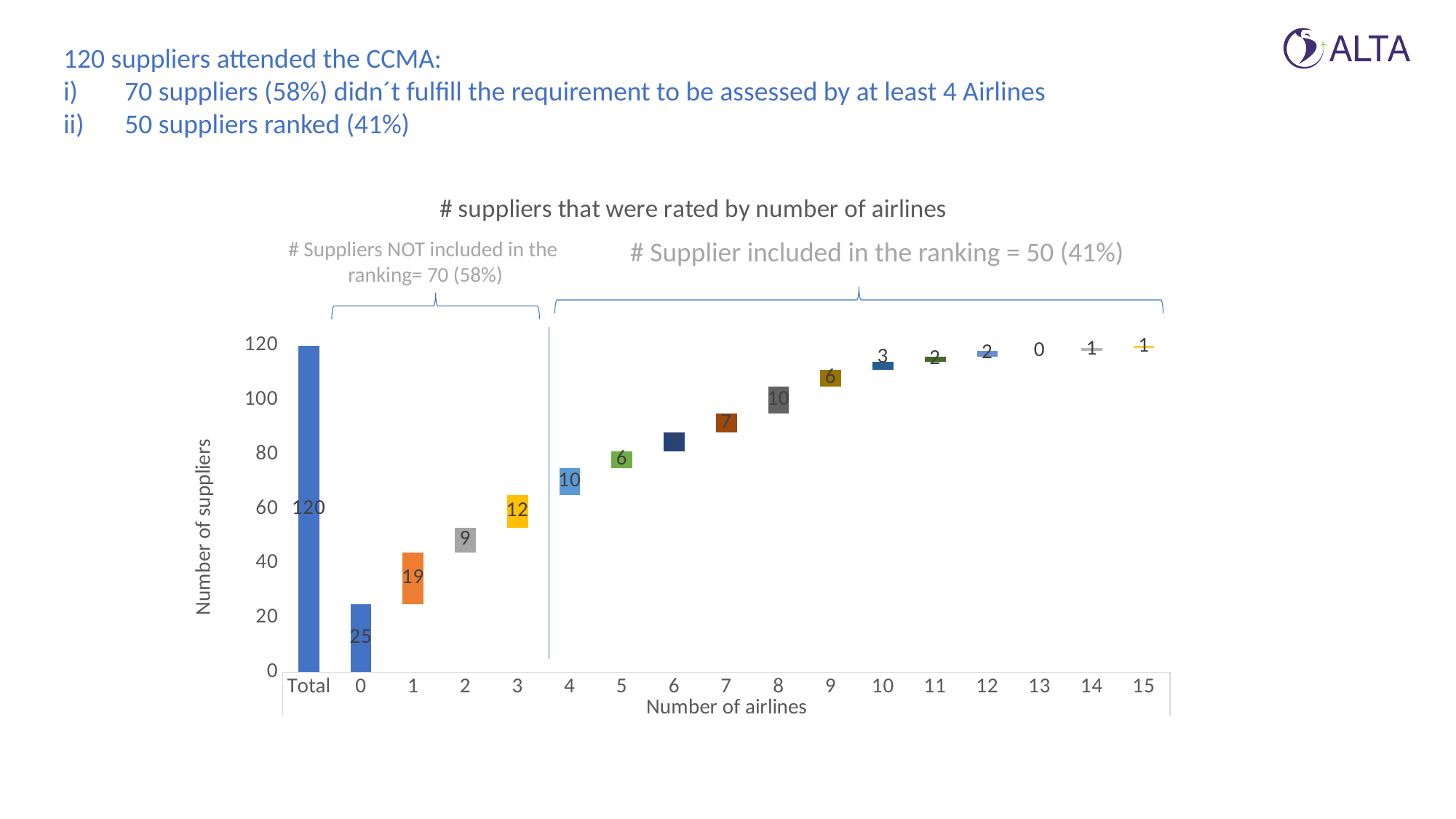
Excluding the Total bar, which number of airlines has the highest number of suppliers? 0 How many suppliers were rated by 13 airlines? 0 How many categories are shown on the x axis, including Total? 17 How many suppliers were rated by 8 airlines? 10 What is the title of the chart? # suppliers that were rated by number of airlines What is the value of the Total bar? 120 What is the difference between the number of suppliers rated by 0 airlines and by 1 airline? 6 How many suppliers were rated by 1 airline? 19 What is the label of the y axis? Number of suppliers How many suppliers were rated by 0 airlines? 25 Which has more suppliers: rated by 2 airlines or rated by 3 airlines? 3 airlines How many suppliers were rated by 3 airlines? 12